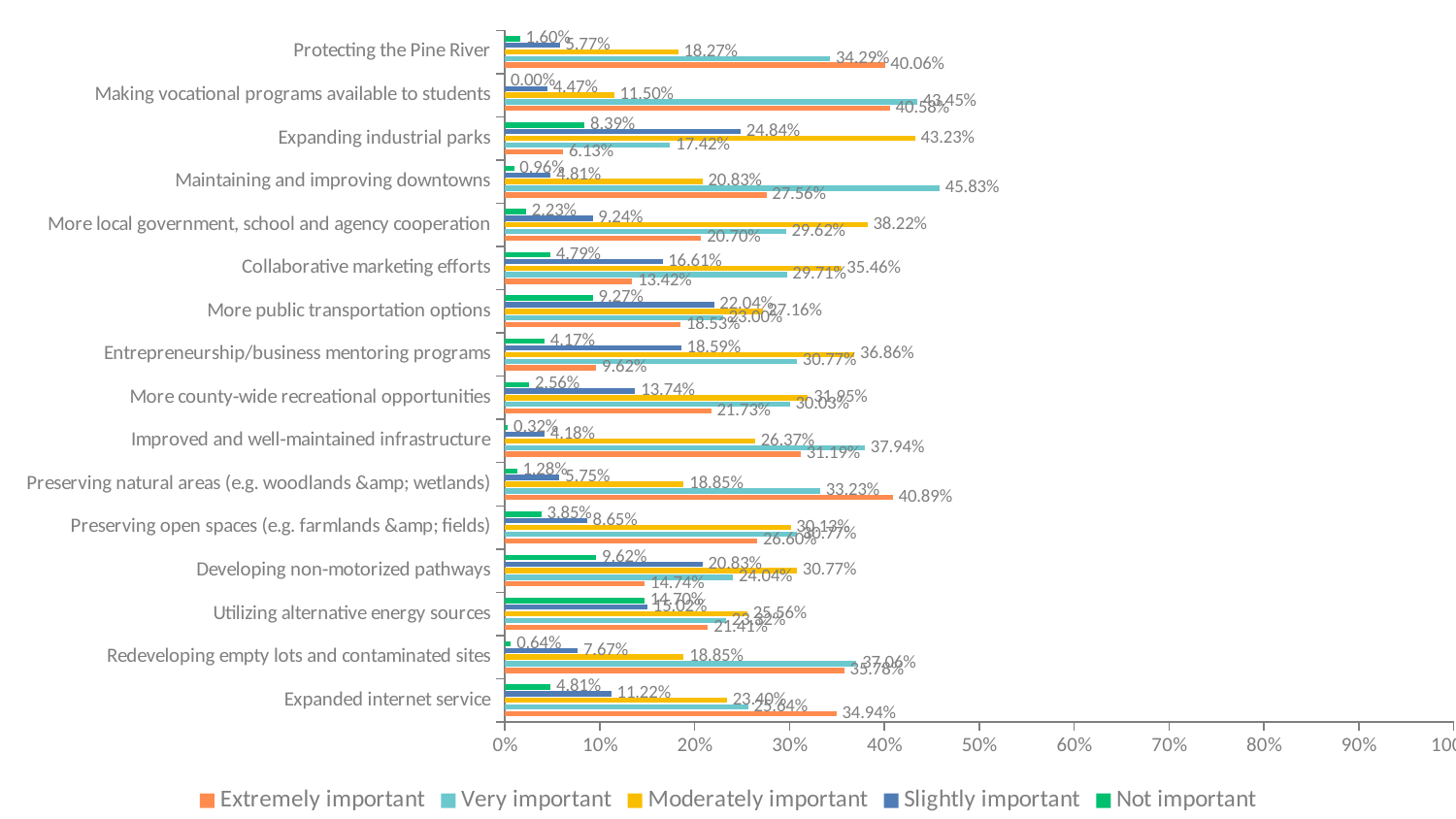
Is the 'Very important' value for Maintaining and improving downtowns greater or less than 40%? greater What is the 'Very important' value for Maintaining and improving downtowns? 45.83% For Expanding industrial parks, which is larger: the 'Moderately important' value or the 'Extremely important' value? Moderately important Which legend entry is shown in orange? Extremely important Which category has the highest 'Moderately important' value? Expanding industrial parks What is the difference between the 'Extremely important' and 'Very important' values for Protecting the Pine River? 5.77% What is the 'Extremely important' value for Protecting the Pine River? 40.06% How many categories are plotted on the chart? 16 What kind of chart is shown on the slide? Bar chart What is the 'Moderately important' value for Expanding industrial parks? 43.23% How many series does the legend list? 5 What is the 'Not important' value for Making vocational programs available to students? 0.00%